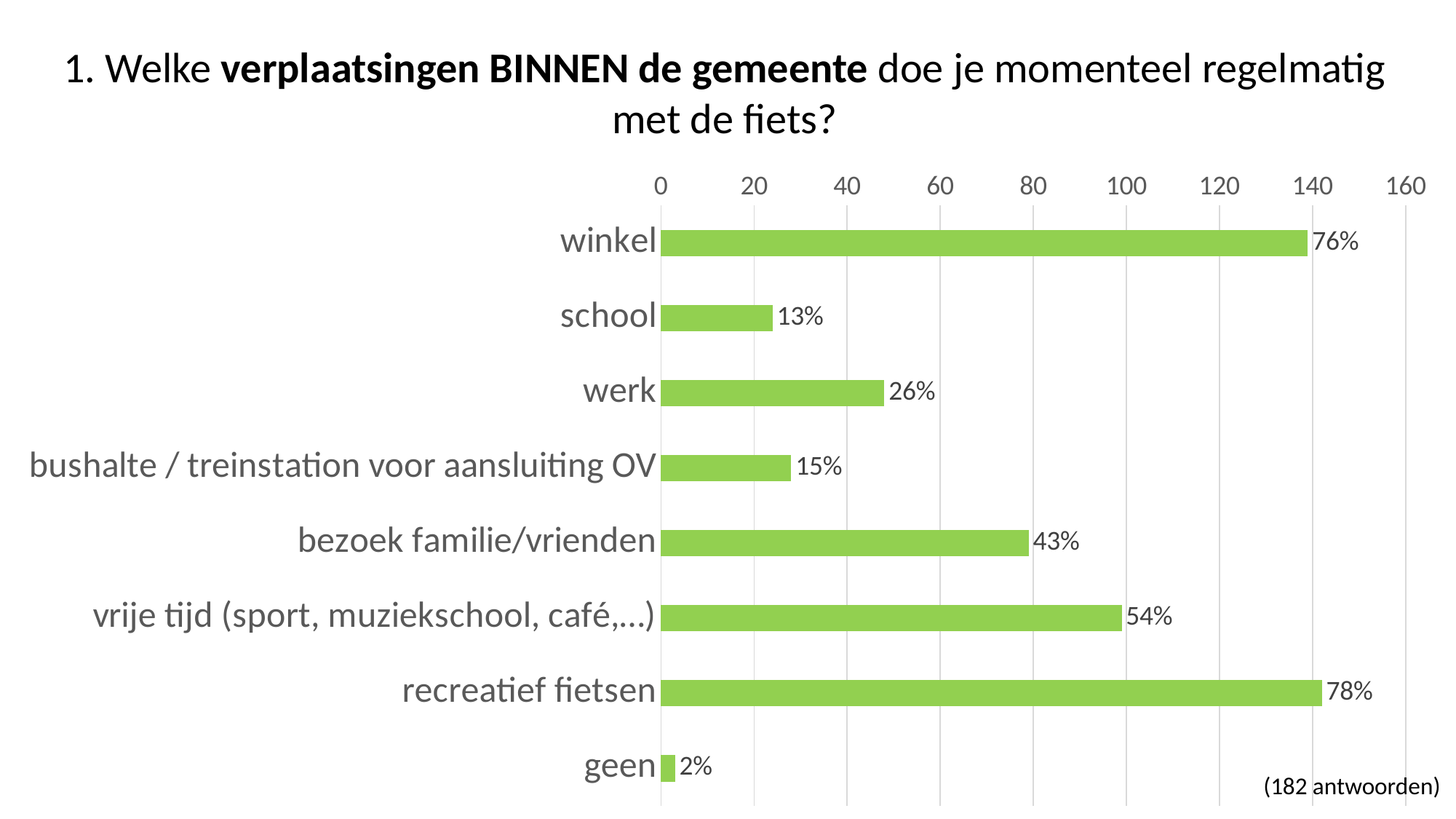
Is the value for 'bezoek familie/vrienden' on the horizontal axis greater or less than 100? less What percentage is shown for 'bushalte / treinstation voor aansluiting OV'? 15% Which has a higher percentage, 'werk' or 'school'? werk What kind of chart is shown on the slide? bar chart What percentage is shown for 'bezoek familie/vrienden'? 43% Is the value for 'winkel' on the horizontal axis greater or less than 120? greater What is the difference in percentage points between 'vrije tijd (sport, muziekschool, café,…)' and 'bezoek familie/vrienden'? 11% How many categories are shown in the chart? 8 How many responses does the note at the bottom right of the chart mention? 182 antwoorden Which category has the highest percentage? recreatief fietsen What percentage is shown for 'winkel'? 76% Which category has the lowest percentage? geen